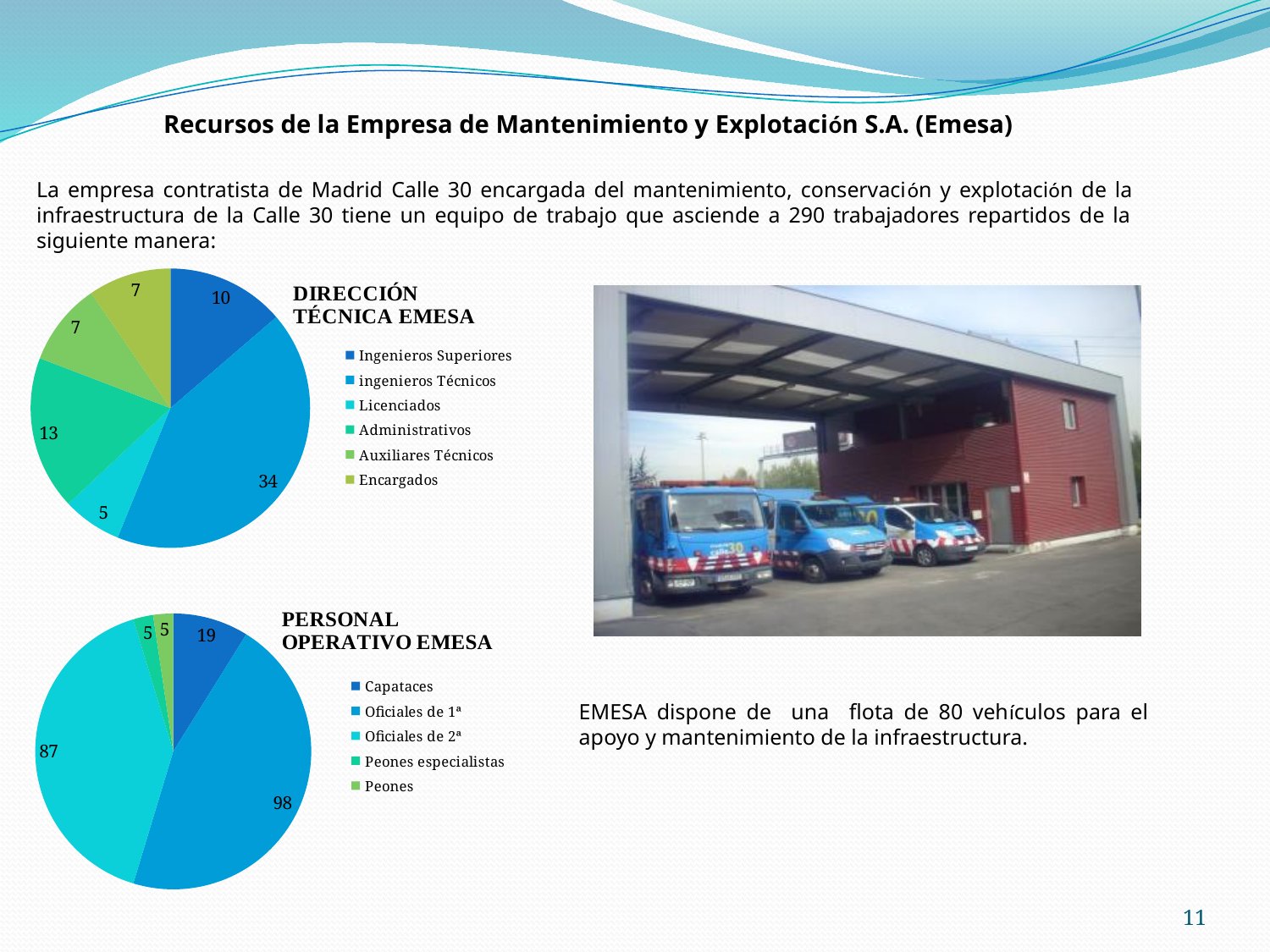
How many categories does the legend of the DIRECCIÓN TÉCNICA EMESA chart list? 6 How many categories does the legend of the PERSONAL OPERATIVO EMESA chart list? 5 In the DIRECCIÓN TÉCNICA EMESA chart, what is the value for ingenieros Técnicos? 34 In the DIRECCIÓN TÉCNICA EMESA chart, what is the difference between ingenieros Técnicos and Ingenieros Superiores? 24 What type of chart is the PERSONAL OPERATIVO EMESA chart? Pie chart In the DIRECCIÓN TÉCNICA EMESA chart, which category has the largest slice? ingenieros Técnicos In the PERSONAL OPERATIVO EMESA chart, what is the difference between Oficiales de 2ª and Capataces? 68 In the PERSONAL OPERATIVO EMESA chart, what is the value for Capataces? 19 In the PERSONAL OPERATIVO EMESA chart, which is larger, Oficiales de 1ª or Oficiales de 2ª? Oficiales de 1ª In the DIRECCIÓN TÉCNICA EMESA chart, which category has the smallest slice? Licenciados In the PERSONAL OPERATIVO EMESA chart, what is the value for Oficiales de 1ª? 98 In the DIRECCIÓN TÉCNICA EMESA chart, what is the value for Administrativos? 13